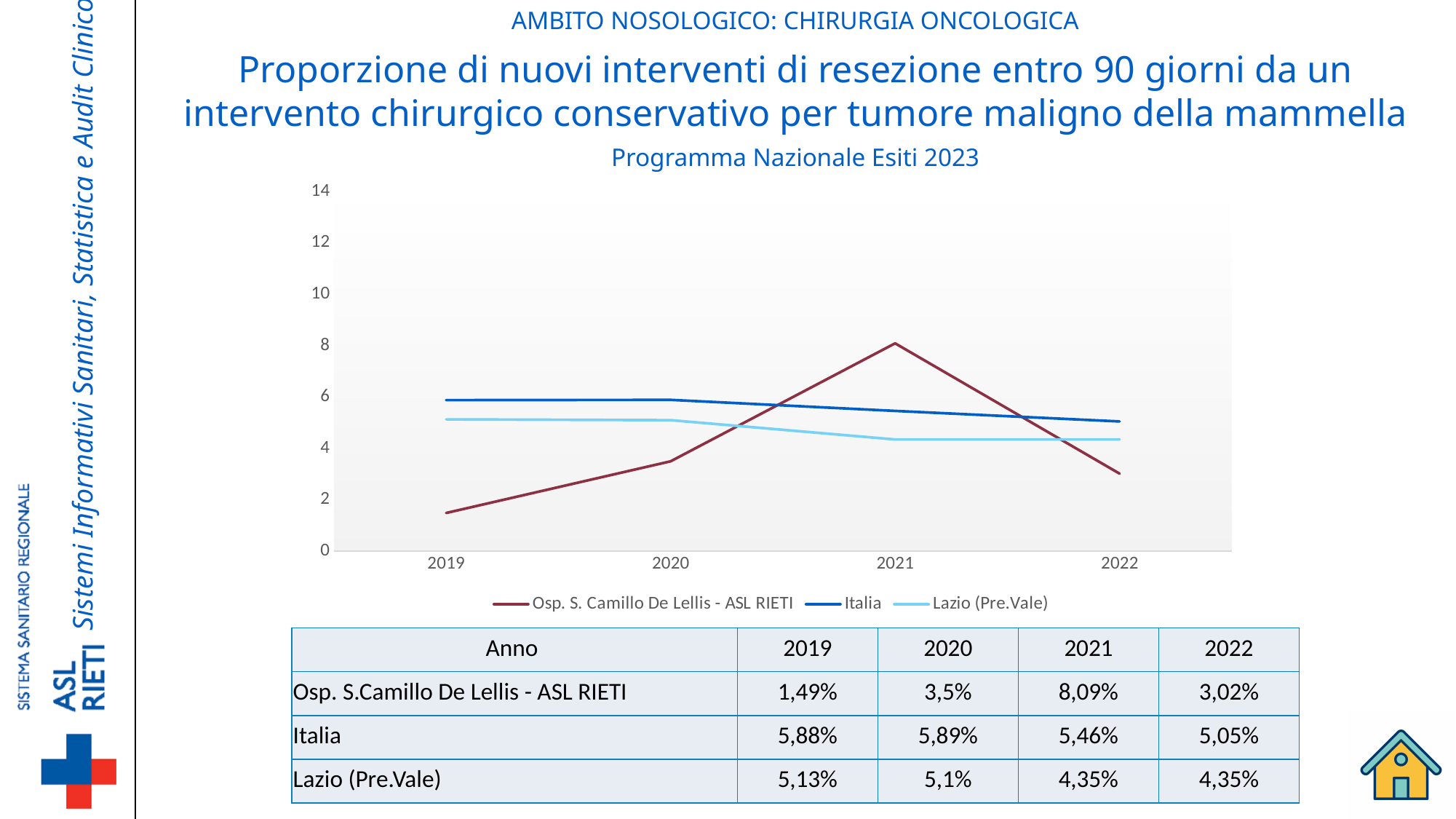
In which year does the Osp. S.Camillo De Lellis - ASL RIETI series reach its highest value? 2021 How many series does the chart legend list? 3 In which year does the Osp. S.Camillo De Lellis - ASL RIETI series have its lowest value? 2019 Which series is drawn with the dark red line in the chart? Osp. S. Camillo De Lellis - ASL RIETI What is the value for Italia in 2019? 5,88% Does the Italia series rise or fall from 2020 to 2022? fall How many years are plotted along the x axis of the chart? 4 What kind of chart is shown on the slide? line chart What is the value for Lazio (Pre.Vale) in 2022? 4,35% What is the value for Osp. S.Camillo De Lellis - ASL RIETI in 2021? 8,09% What is the difference between the Osp. S.Camillo De Lellis - ASL RIETI value and the Italia value in 2021? 2,63% In 2019, which is larger: the value for Italia or the value for Osp. S.Camillo De Lellis - ASL RIETI? Italia